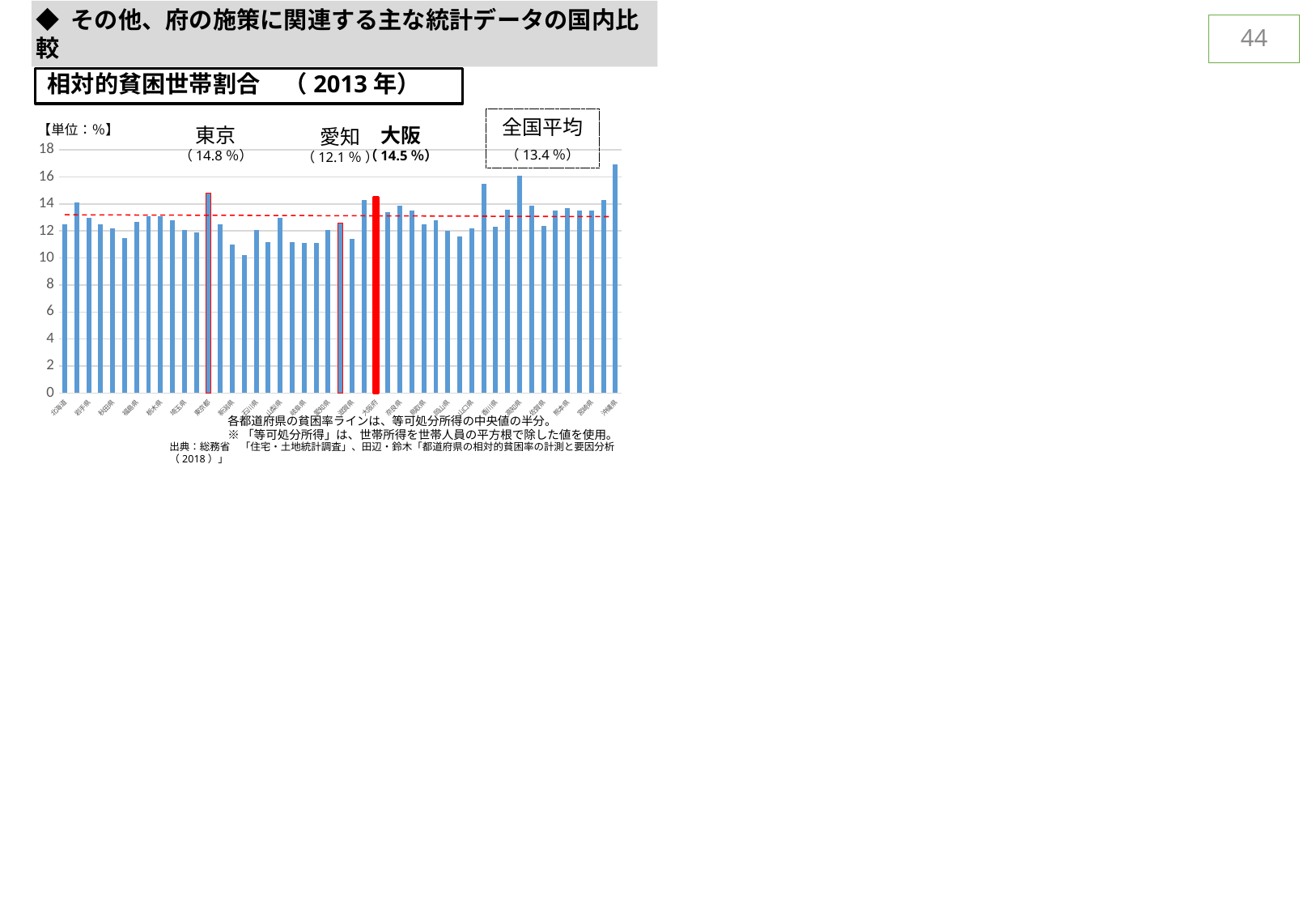
What is the relative poverty household ratio for 大阪 (Osaka) shown on the chart? 14.5% Is the value for 大阪 higher or lower than the national average? higher What kind of chart is used on this slide? bar chart What is the national average (全国平均) value shown on the chart? 13.4% What is the relative poverty household ratio for 愛知 (Aichi) shown on the chart? 12.1% By how much does 大阪 (14.5%) exceed the national average (13.4%)? 1.1 percentage points What unit is the chart's data expressed in, according to the label above the chart? % Which has the higher relative poverty household ratio, 大阪 or 愛知? 大阪 Is the value for 愛知 greater or less than 14? less What is the relative poverty household ratio for 東京 (Tokyo) shown on the chart? 14.8% What is the difference between the values for 東京 (14.8%) and 愛知 (12.1%)? 2.7 percentage points What is the difference between the values for 東京 (14.8%) and 大阪 (14.5%)? 0.3 percentage points